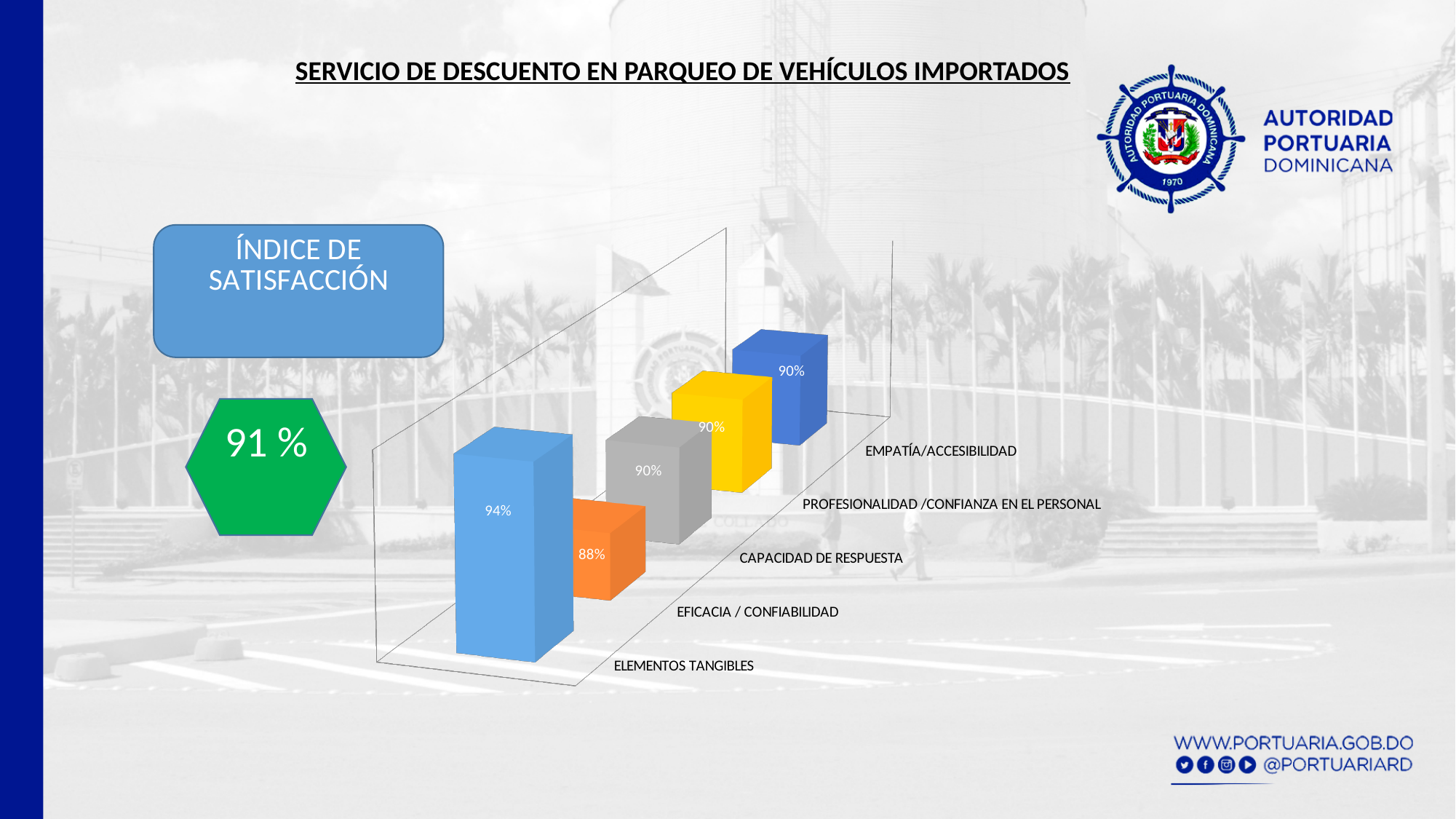
What is the value for CAPACIDAD DE RESPUESTA? 90% Which is larger, the value for ELEMENTOS TANGIBLES or the value for PROFESIONALIDAD /CONFIANZA EN EL PERSONAL? ELEMENTOS TANGIBLES What is the value for ELEMENTOS TANGIBLES? 94% What kind of chart is shown on the slide? Bar chart What is the value for EFICACIA / CONFIABILIDAD? 88% How many categories are shown in the chart? 5 Which category has the highest value? ELEMENTOS TANGIBLES What is the value for EMPATÍA/ACCESIBILIDAD? 90% What colour is the bar for EFICACIA / CONFIABILIDAD? Orange What is the overall satisfaction index (ÍNDICE DE SATISFACCIÓN) shown on the slide? 91 % What is the difference between the values for ELEMENTOS TANGIBLES and EFICACIA / CONFIABILIDAD? 6% Which category has the lowest value? EFICACIA / CONFIABILIDAD